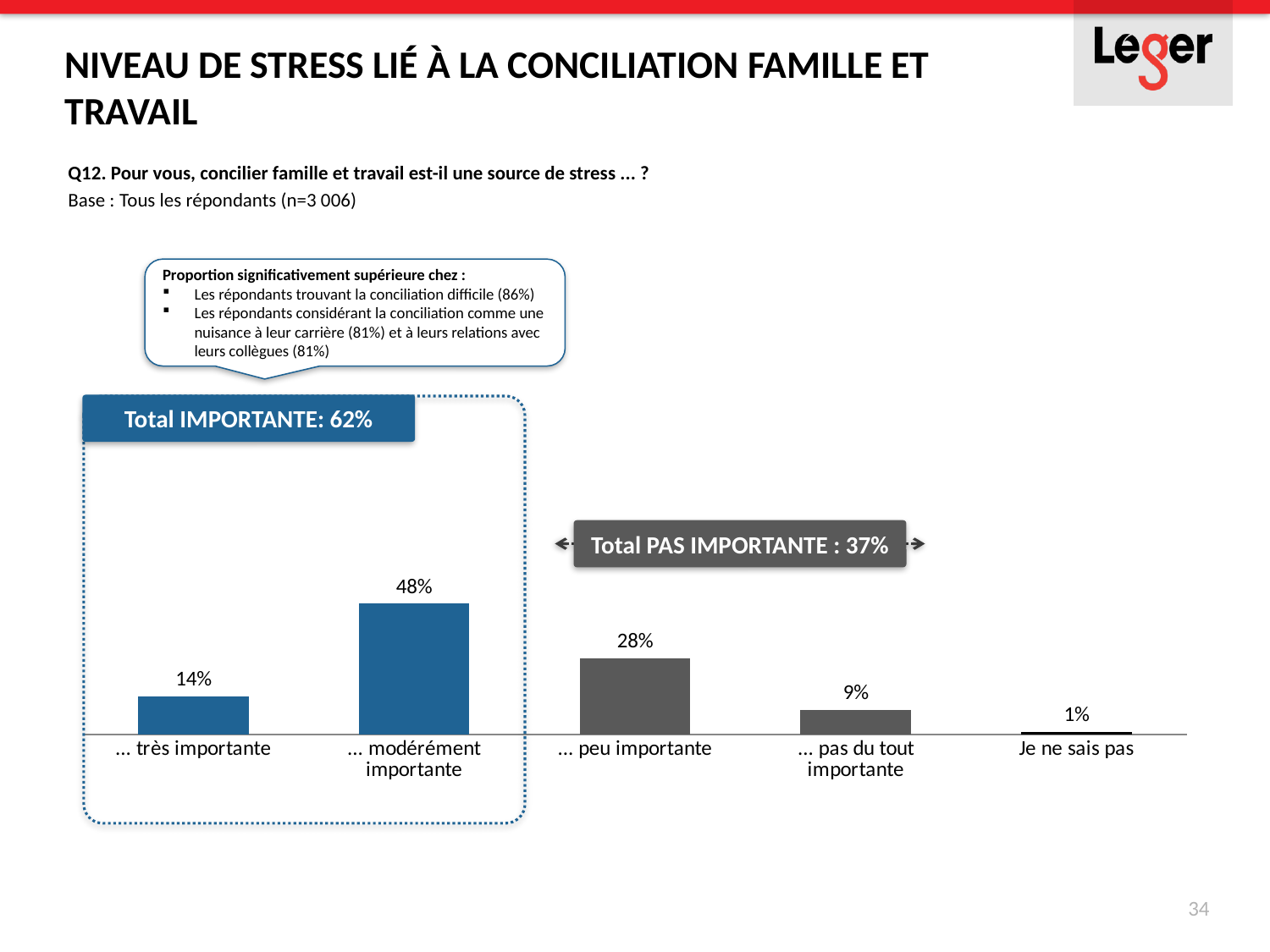
What is the value for "... peu importante"? 28% What is the difference between "... modérément importante" and "... peu importante"? 20% What is the value for "Je ne sais pas"? 1% Which category has the highest value? ... modérément importante What is the value for "... modérément importante"? 48% What is the "Total IMPORTANTE" value shown on the chart? 62% Which is larger, "... très importante" or "... pas du tout importante"? ... très importante How many categories are shown on the chart? 5 Which category has the lowest value? Je ne sais pas What is the value for "... très importante"? 14% What kind of chart is shown on the slide? Bar chart What is the "Total PAS IMPORTANTE" value shown on the chart? 37%